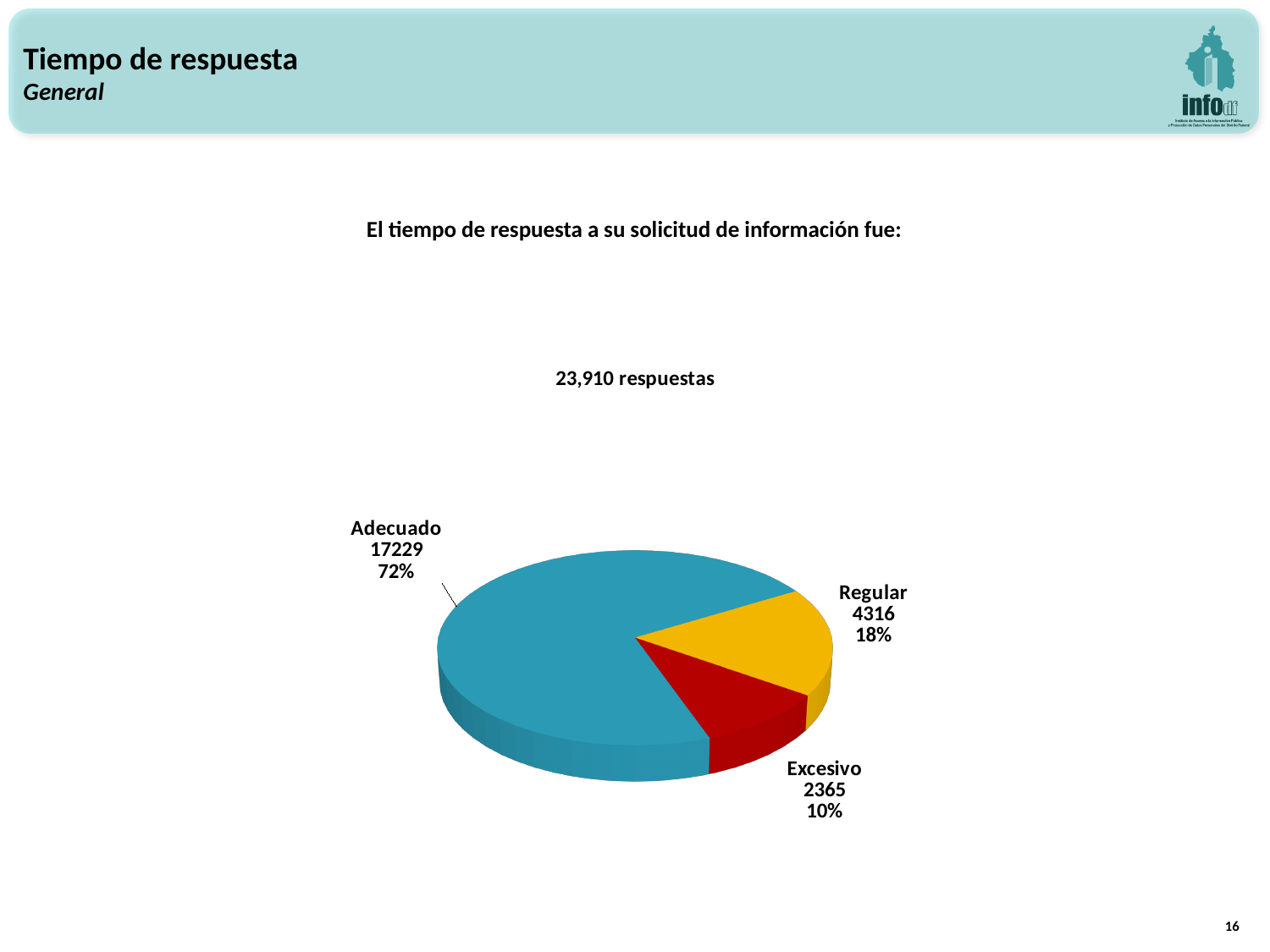
Which category has the smallest slice? Excesivo What colour is the Regular slice? yellow What share of the pie does Adecuado represent? 72% What is the number of responses for Regular? 4316 What is the number of responses for Excesivo? 2365 What share of the pie does Excesivo represent? 10% What is the difference in responses between Regular and Excesivo? 1951 How many slices does the pie chart have? 3 Which has more responses, Regular or Excesivo? Regular Which category has the largest slice? Adecuado What kind of chart is shown on the slide? pie chart What is the number of responses for Adecuado? 17229